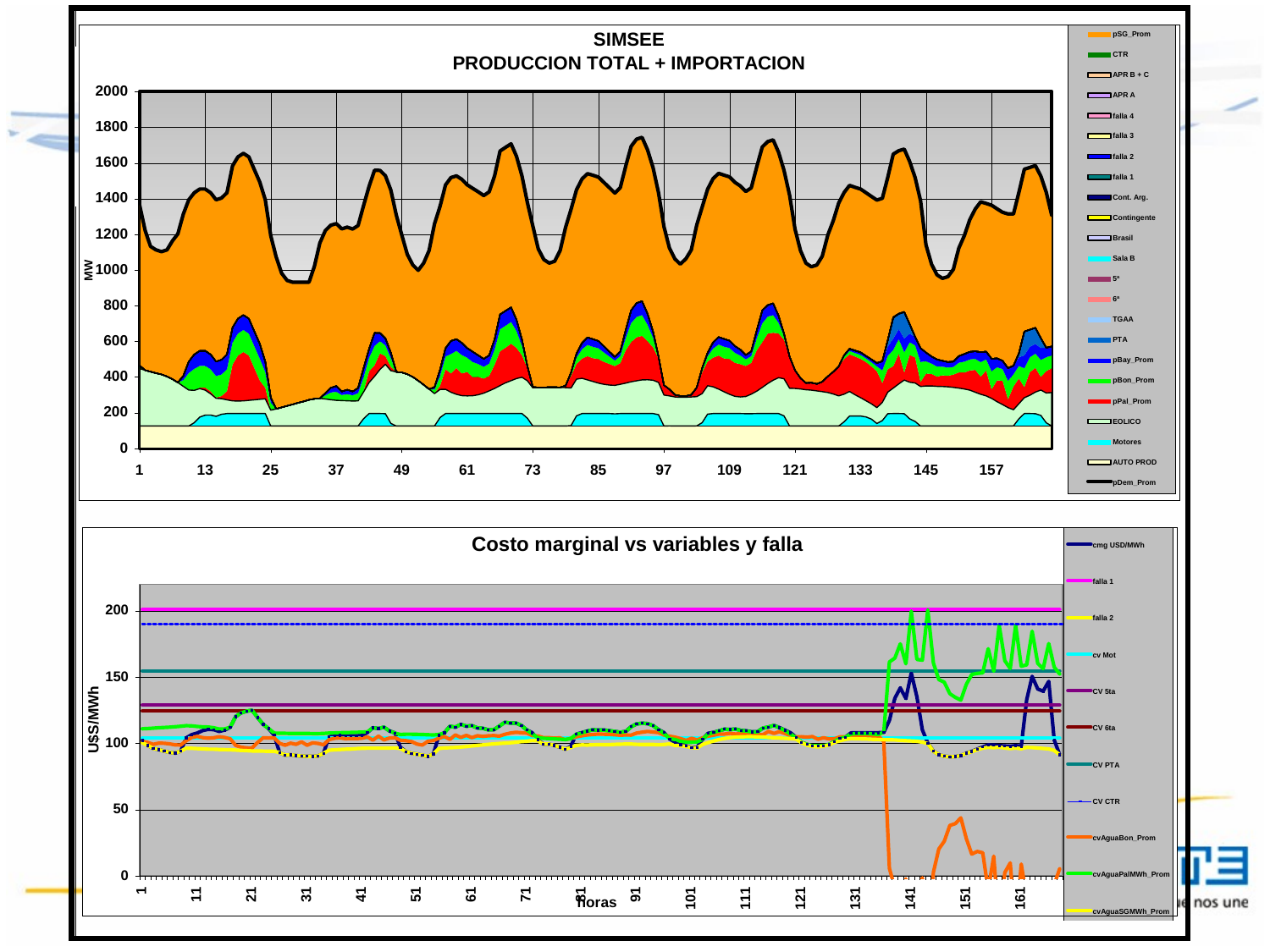
What is the title of the top chart? SIMSEE PRODUCCION TOTAL + IMPORTACION In the bottom chart 'Costo marginal vs variables y falla', is the value of the CV 5ta line greater or less than 150? less What is the title of the bottom chart? Costo marginal vs variables y falla What kind of chart is the top chart, 'SIMSEE PRODUCCION TOTAL + IMPORTACION'? stacked area chart How many series does the legend of the bottom chart 'Costo marginal vs variables y falla' list? 11 In the bottom chart 'Costo marginal vs variables y falla', is the value of the CV CTR line greater or less than 200? less In the top chart 'SIMSEE PRODUCCION TOTAL + IMPORTACION', is the highest value of the pDem_Prom line greater or less than 1800? less What kind of chart is the bottom chart, 'Costo marginal vs variables y falla'? line chart How many series does the legend of the top chart 'SIMSEE PRODUCCION TOTAL + IMPORTACION' list? 23 What is the y-axis label of the bottom chart 'Costo marginal vs variables y falla'? U$S/MWh